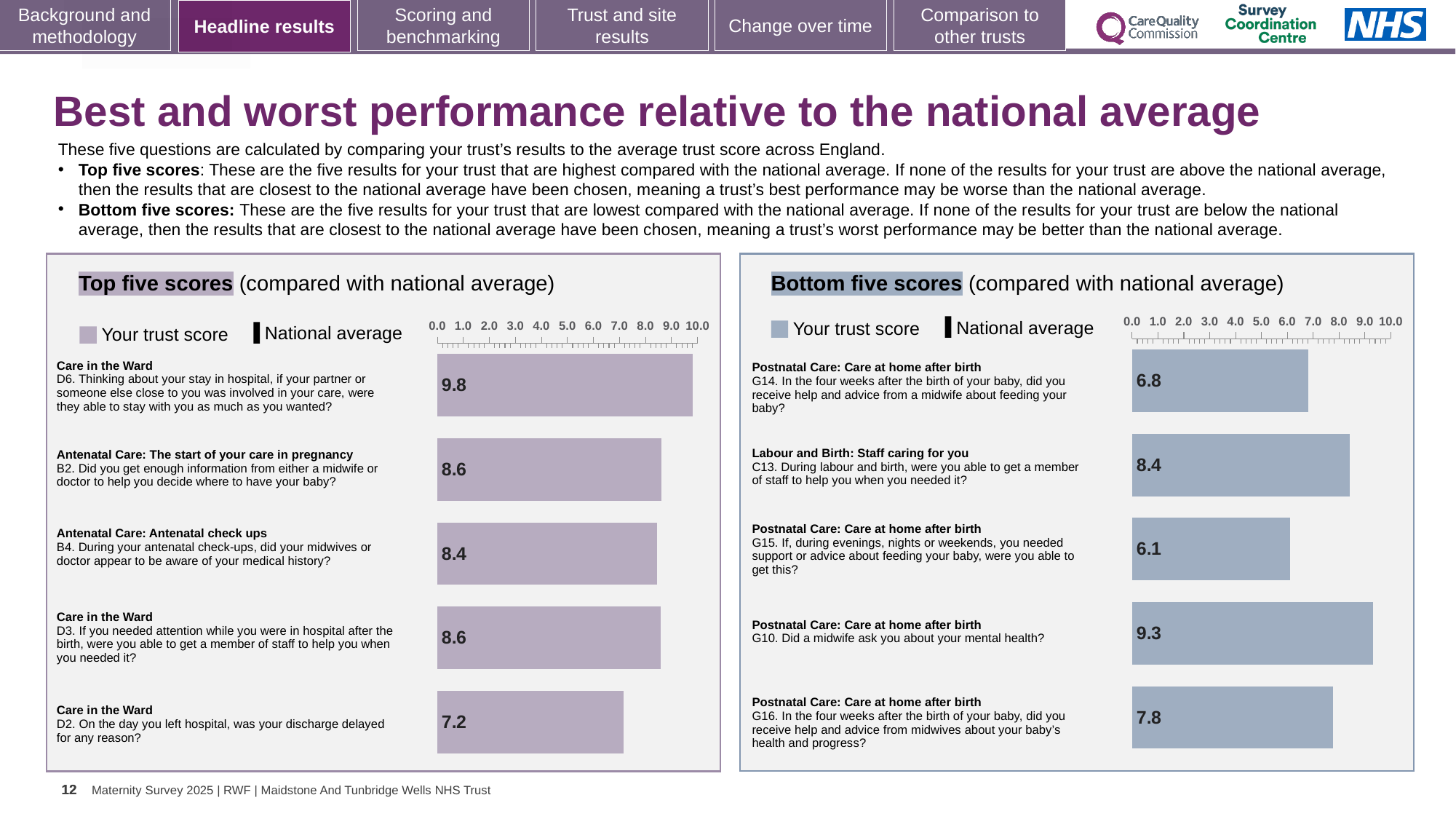
In the Bottom five scores chart, what is the difference between the trust scores for G10 and G15? 3.2 In the Bottom five scores chart, which question has the highest trust score? G10 (9.3) In the Top five scores chart, which question has the lowest trust score? D2 (7.2) In the Top five scores chart, what is the trust score for B4 (midwives or doctor aware of your medical history)? 8.4 What type of chart is used in the Bottom five scores panel? Bar chart In the Top five scores chart, which question has the highest trust score? D6 (9.8) In the Top five scores chart, what is the trust score for D6 (partner or someone close able to stay with you as much as you wanted)? 9.8 In the Bottom five scores chart, which question has the lowest trust score? G15 (6.1) How many bars are plotted in the Top five scores chart? 5 In the Bottom five scores chart, what is the trust score for G10 (did a midwife ask you about your mental health)? 9.3 In the Bottom five scores chart, which has the larger trust score, G14 or G16? G16 In the Top five scores chart, what is the difference between the trust scores for D6 and D2? 2.6